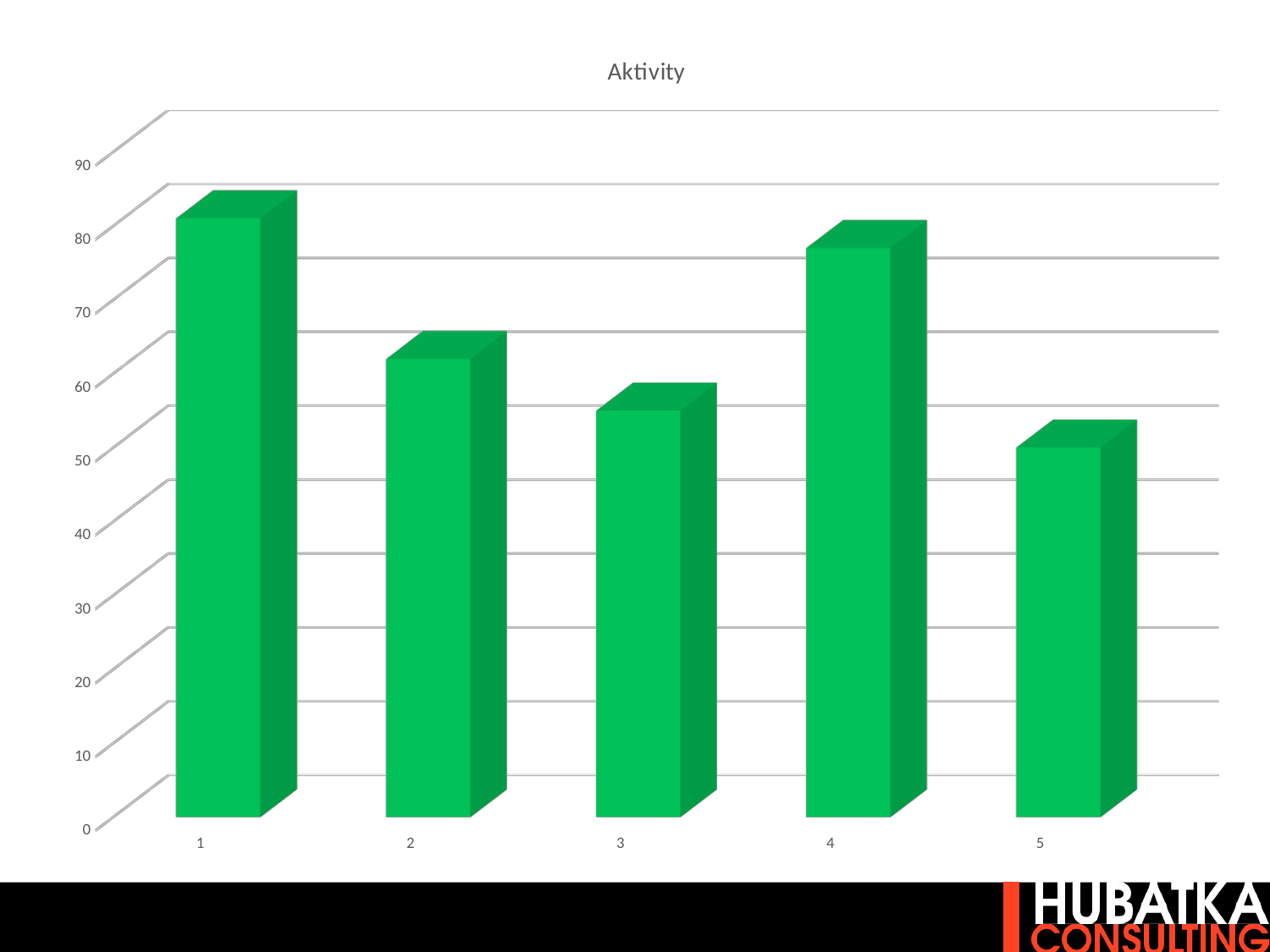
Is the value for category 5 greater or less than 60? less Is the value for category 3 greater or less than 50? greater How many bars (categories) are plotted in the chart? 5 What is the title of the chart? Aktivity Is the value for category 4 greater or less than 70? greater Do the values rise or fall from category 1 to category 3? fall Which category has the lowest bar? 5 What kind of chart is shown on the slide? bar chart Which is larger, the value for category 2 or the value for category 3? category 2 Which category has the highest bar? 1